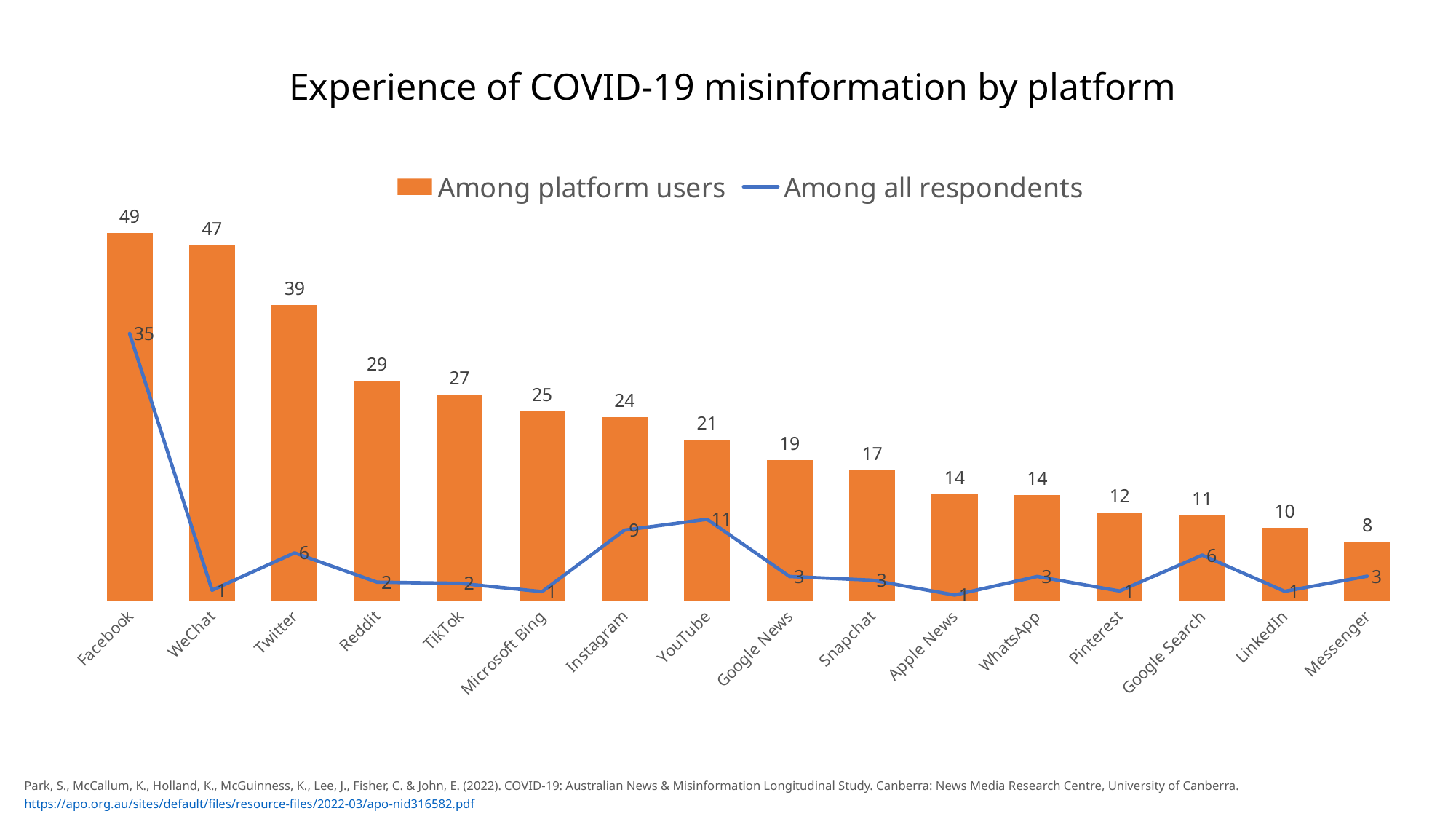
What kind of chart is this? Combined bar and line chart Which platform has the lowest value among platform users? Messenger What is the value for Twitter among all respondents? 6 What is the value for YouTube among all respondents? 11 How many series does the legend list? 2 Which is larger among platform users: Reddit or TikTok? Reddit What is the difference between the Facebook values among platform users and among all respondents? 14 Do the values among platform users rise or fall from left to right along the x axis? Fall Which platform has the highest value among platform users? Facebook How many platforms are shown on the x axis? 16 What is the difference between the Facebook and WeChat values among platform users? 2 What is the value for Facebook among platform users? 49